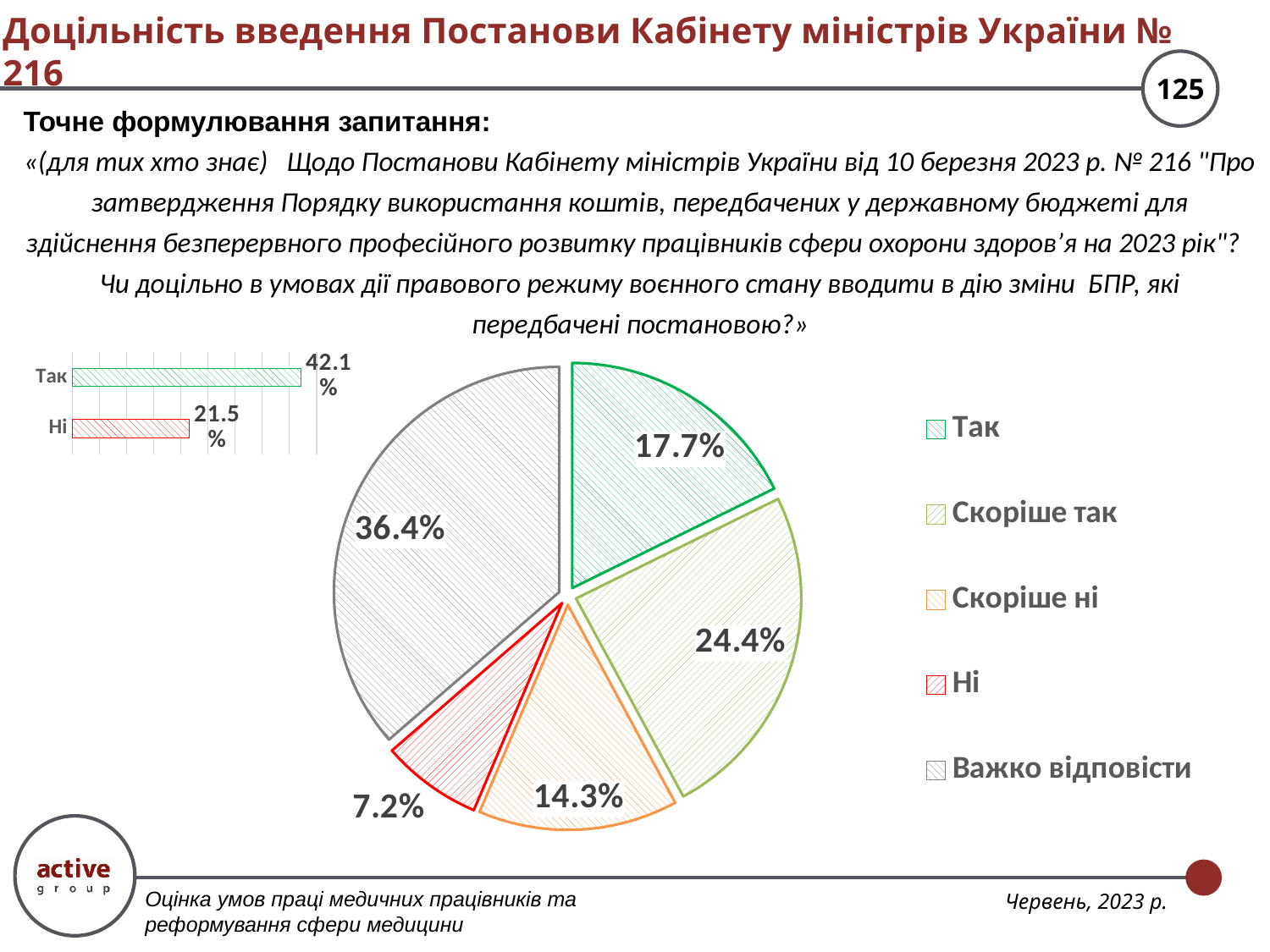
In the pie chart, which category has the smallest slice? Ні In the small bar chart at the top left, what is the value for "Так"? 42.1% In the pie chart, what percentage is shown for "Скоріше так"? 24.4% What type of chart is the small chart at the top left of the slide? Bar chart How many categories does the pie chart's legend list? 5 In the pie chart, what percentage is shown for "Ні"? 7.2% In the pie chart, what percentage is shown for "Важко відповісти"? 36.4% In the small bar chart at the top left, what is the difference between "Так" and "Ні"? 20.6% In the pie chart, which category has the largest slice? Важко відповісти In the pie chart, what is the difference between "Скоріше так" and "Скоріше ні"? 10.1% In the small bar chart at the top left, what is the value for "Ні"? 21.5% In the pie chart, which is larger: "Так" or "Скоріше ні"? Так